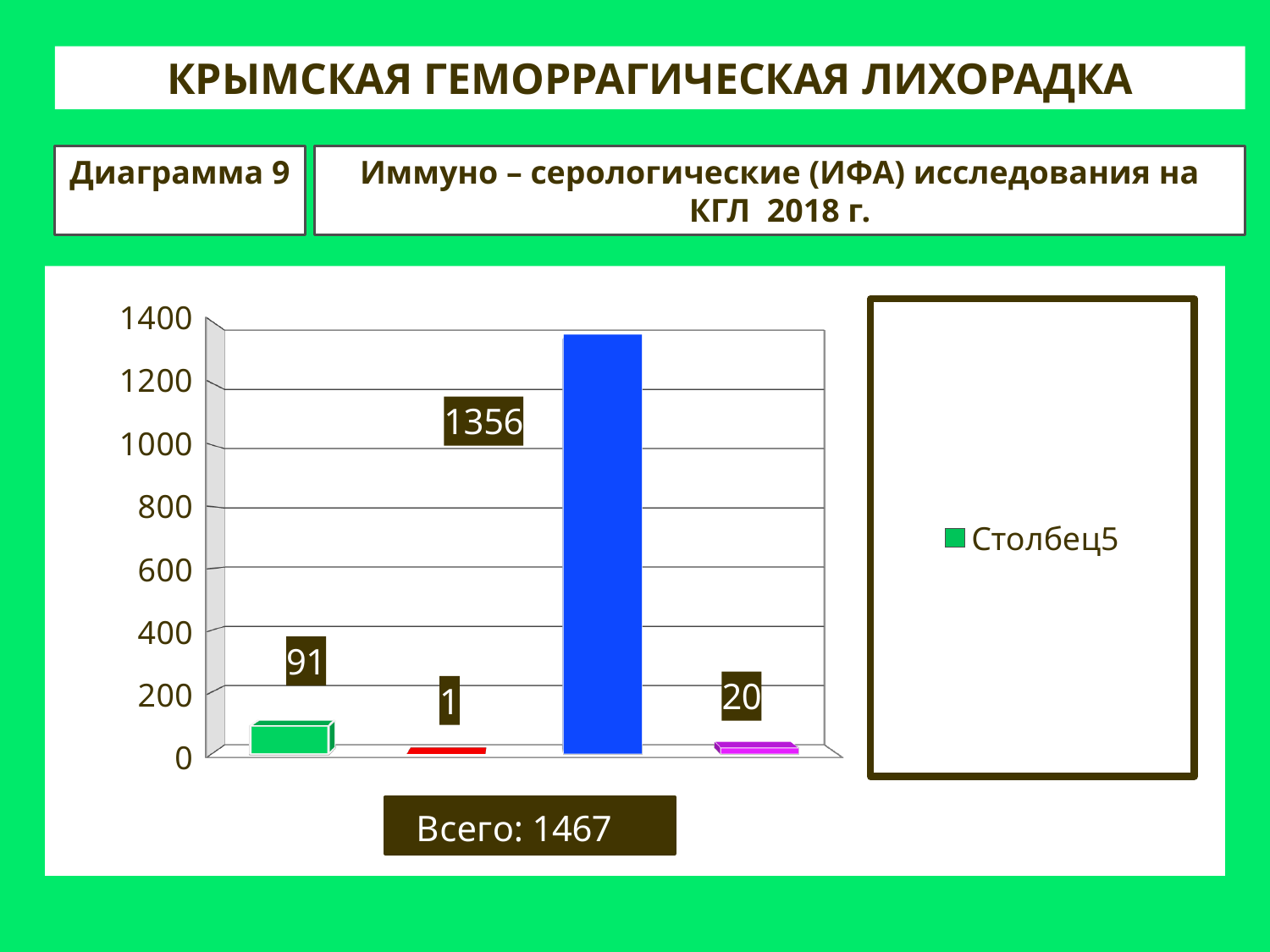
What is the value shown for the green bar (first from the left)? 91 What total is printed below the chart? Всего: 1467 Which is larger, the value of the green bar or the value of the magenta bar? the green bar (91) What is the value shown for the blue bar? 1356 Which bar has the highest value? the blue bar (1356) How many bars are plotted in the chart? 4 What is the value shown for the red bar (second from the left)? 1 Which bar has the lowest value? the red bar (1) What type of chart is shown on the slide? bar chart What entry does the chart legend list? Столбец5 What is the difference between the blue bar's value and the green bar's value? 1265 What is the value shown for the magenta bar (rightmost)? 20